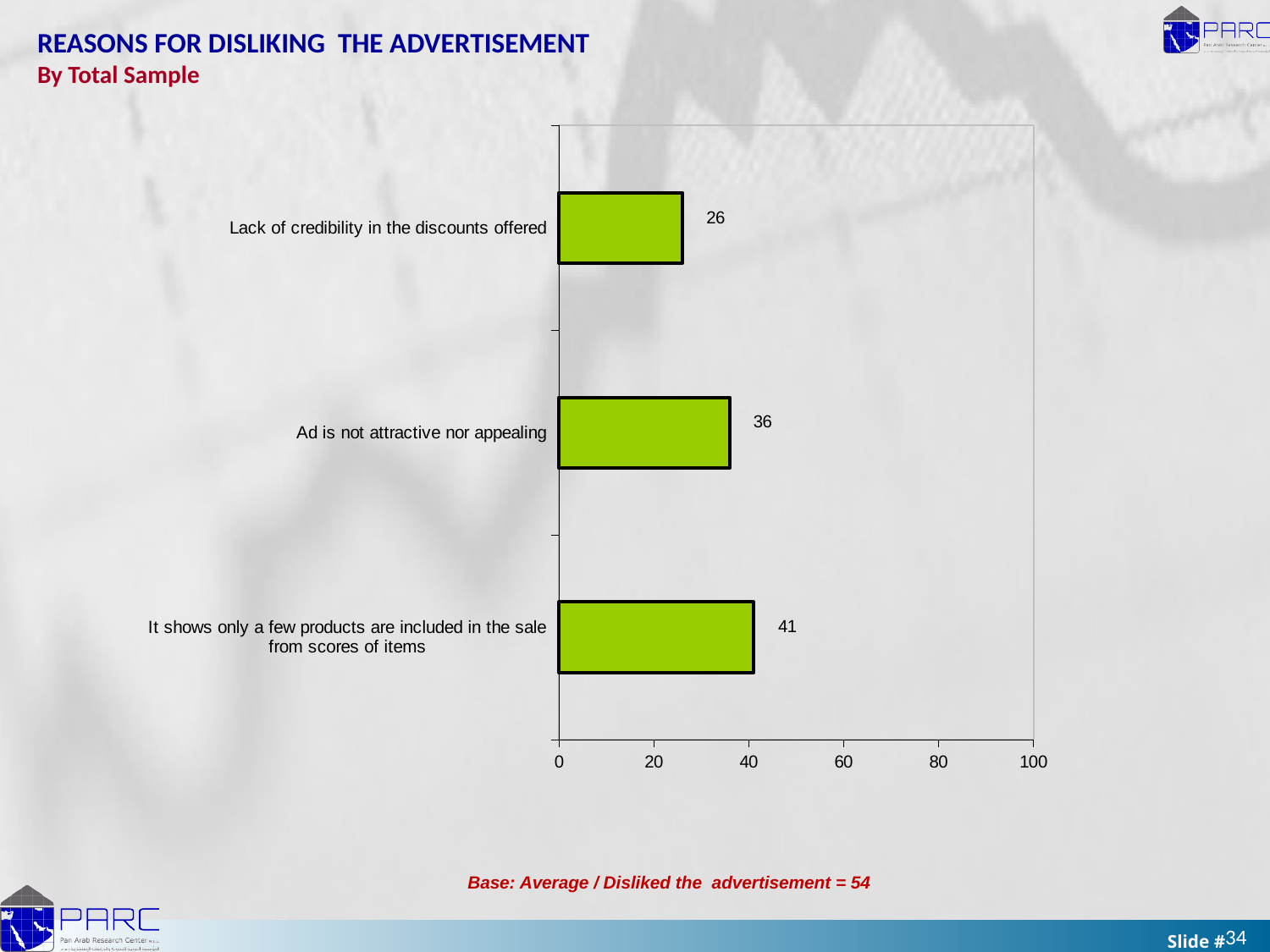
What is the value for "Ad is not attractive nor appealing"? 36 What kind of chart is shown on the slide? bar chart What is the value for "It shows only a few products are included in the sale from scores of items"? 41 Which reason has the lowest value? Lack of credibility in the discounts offered What is the base stated below the chart? Average / Disliked the advertisement = 54 What is the value for "Lack of credibility in the discounts offered"? 26 Which is larger: the value for "Ad is not attractive nor appealing" or for "Lack of credibility in the discounts offered"? Ad is not attractive nor appealing How many reasons are shown in the chart? 3 Which reason has the highest value? It shows only a few products are included in the sale from scores of items What is the difference between the values for "It shows only a few products are included in the sale from scores of items" and "Lack of credibility in the discounts offered"? 15 Is the value for "It shows only a few products are included in the sale from scores of items" greater or less than 60? less What is the difference between the values for "Ad is not attractive nor appealing" and "Lack of credibility in the discounts offered"? 10